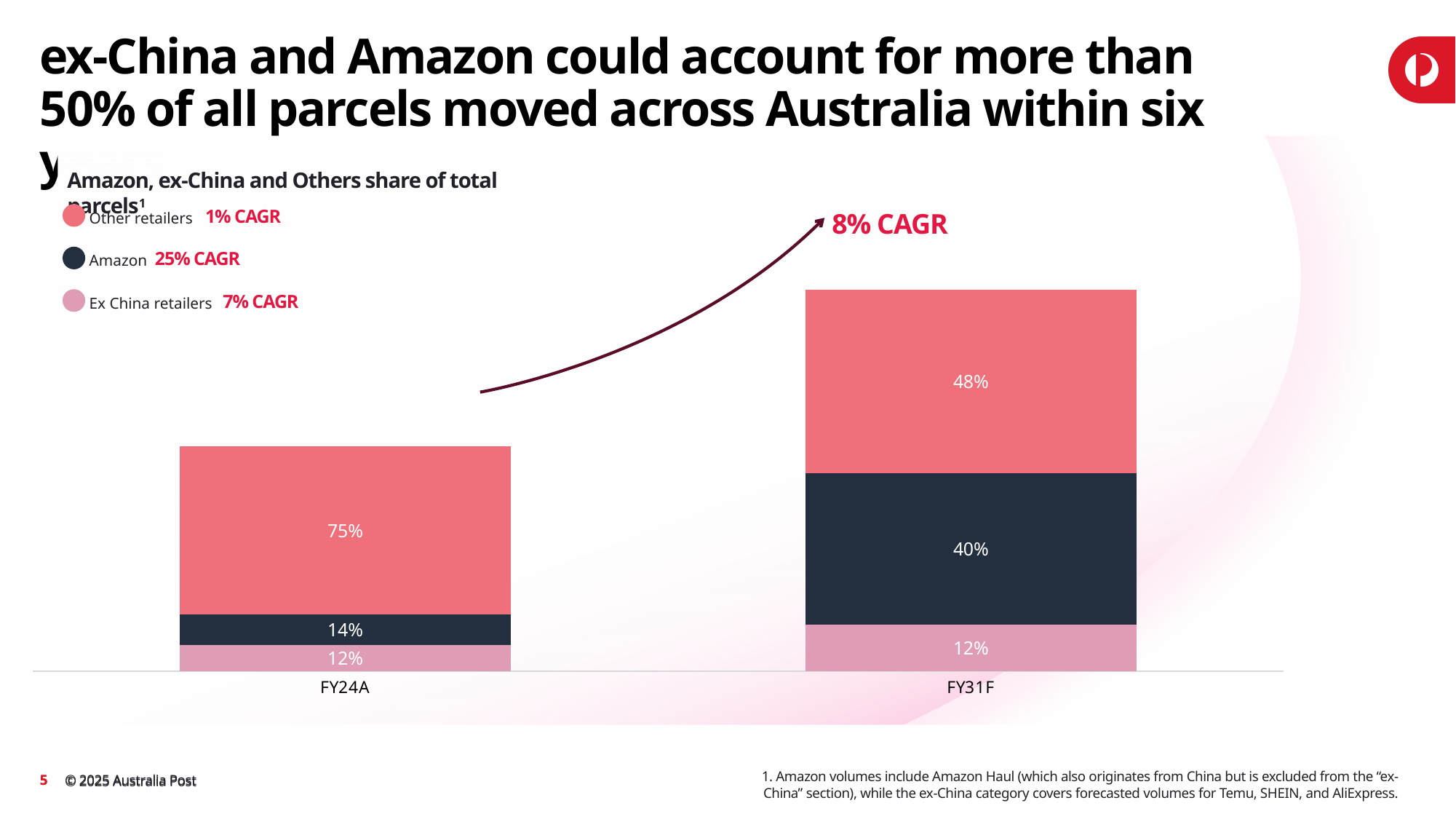
Does the Amazon share rise or fall from FY24A to FY31F? Rises What is the Other retailers share of total parcels in FY31F? 48% Which series has the largest share in the FY24A bar? Other retailers In FY31F, which is larger: the Amazon share or the Other retailers share? Other retailers How many series does the legend list? 3 What is the Amazon share of total parcels in FY24A? 14% What CAGR is shown next to Amazon in the legend? 25% CAGR By how many percentage points does the Amazon share change from FY24A to FY31F? 26 percentage points What kind of chart is shown on the slide? Stacked bar chart What is the Amazon share of total parcels in FY31F? 40% What is the Ex China retailers share in FY31F? 12% How many categories (years) are shown on the x axis? 2